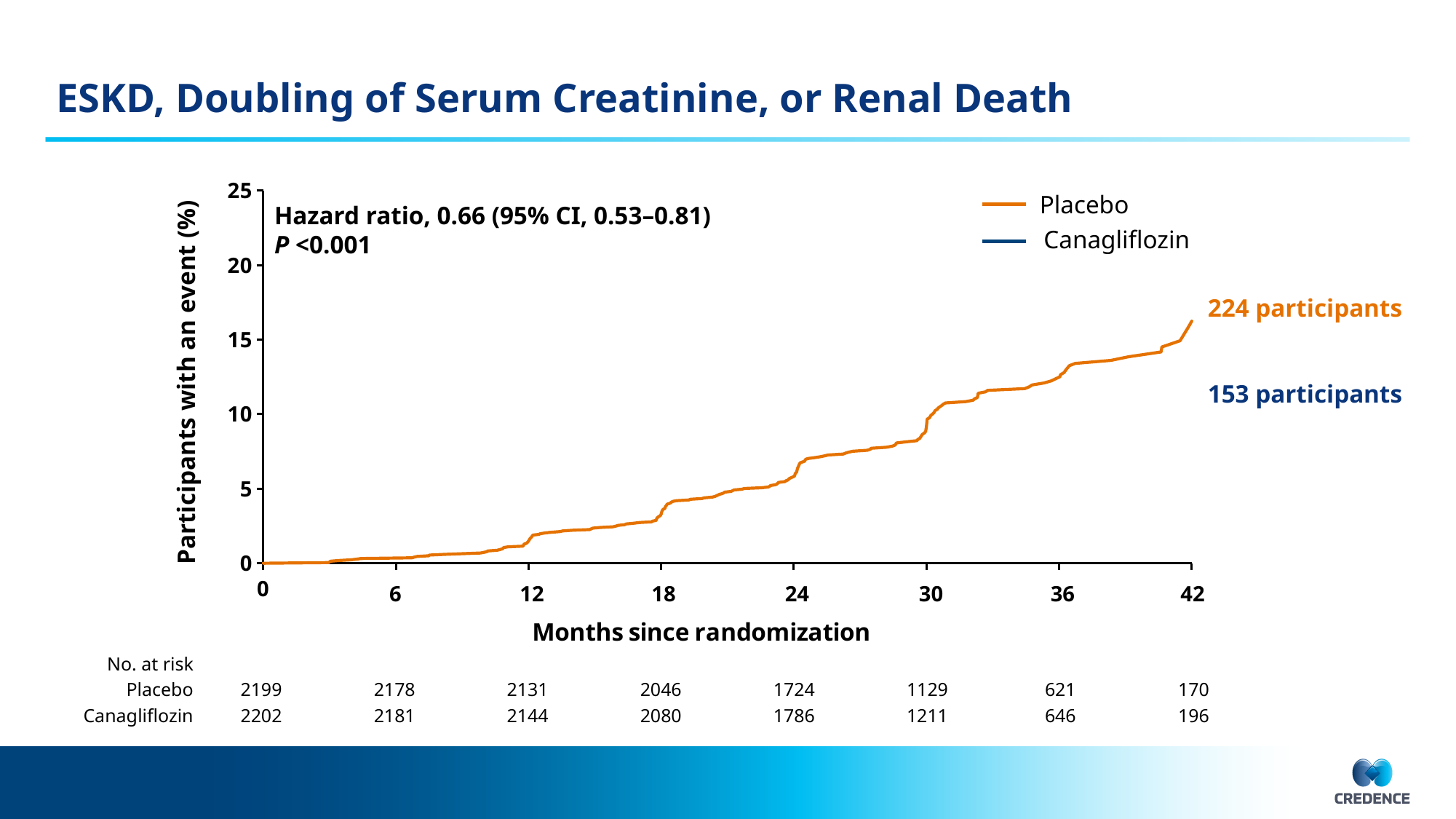
Is the Placebo value at 18 months greater or less than 5? less Does the Placebo curve rise or fall as months since randomization increase? Rise What is the difference between the number at risk for Canagliflozin and Placebo at month 0? 3 How many participants had an event in the Placebo group, according to the annotation on the chart? 224 participants How many participants had an event in the Canagliflozin group, according to the annotation on the chart? 153 participants How many series does the legend list? 2 At 42 months, which group has more participants at risk, Placebo or Canagliflozin? Canagliflozin Is the Placebo value at 42 months greater or less than 15? greater What kind of chart is shown on the slide? Line chart What is the number at risk for Canagliflozin at 24 months? 1786 What hazard ratio is printed on the chart? 0.66 (95% CI, 0.53–0.81) Is the Placebo value at 24 months greater or less than 10? less